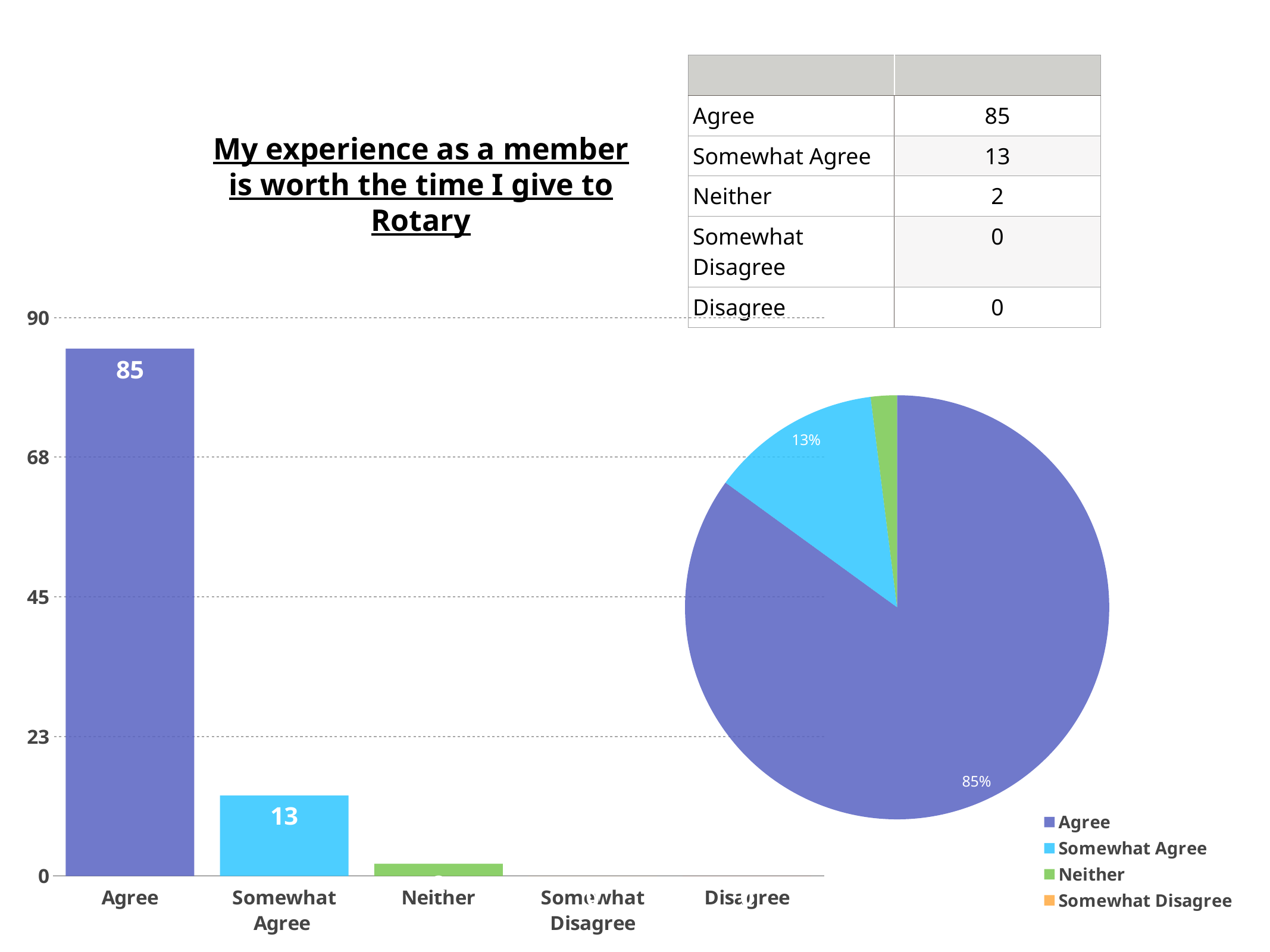
In the bar chart, what is the value for Agree? 85 In the bar chart, what is the difference between the values for Agree and Somewhat Agree? 72 In the pie chart, what share does the Agree slice have? 85% In the bar chart, which category has the highest value? Agree In the bar chart, what is the value for Somewhat Agree? 13 What kind of chart is the chart on the left of the slide? bar chart In the bar chart, is the value for Agree greater or less than 68? greater How many entries does the legend of the pie chart list? 4 In the bar chart, which is larger: Somewhat Agree or Neither? Somewhat Agree In the pie chart, what share does the Somewhat Agree slice have? 13% In the bar chart, do the values rise or fall from left to right along the x axis? fall How many categories are shown on the x axis of the bar chart? 5